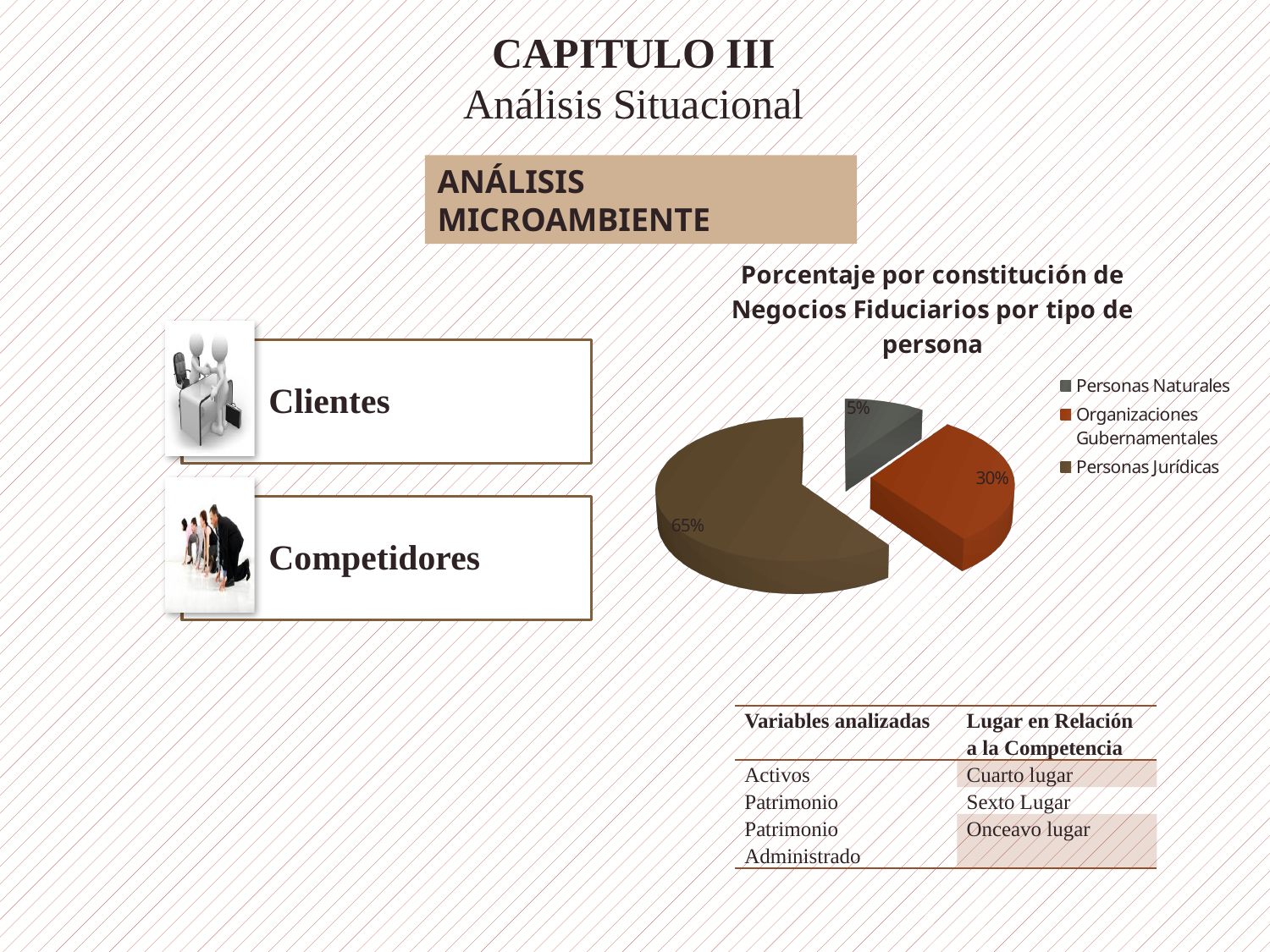
What is the difference in percentage points between Personas Jurídicas and Organizaciones Gubernamentales in the pie chart? 35 What is the title of the pie chart? Porcentaje por constitución de Negocios Fiduciarios por tipo de persona Which colour represents Organizaciones Gubernamentales in the pie chart legend? Red What percentage of the pie chart corresponds to Personas Naturales? 5% Which is larger in the pie chart, Organizaciones Gubernamentales or Personas Naturales? Organizaciones Gubernamentales Which category has the largest slice in the pie chart? Personas Jurídicas What percentage of the pie chart corresponds to Personas Jurídicas? 65% What percentage of the pie chart corresponds to Organizaciones Gubernamentales? 30% How many categories does the pie chart legend list? 3 Which category has the smallest slice in the pie chart? Personas Naturales What is the difference in percentage points between Organizaciones Gubernamentales and Personas Naturales in the pie chart? 25 What kind of chart is shown on the slide? Pie chart